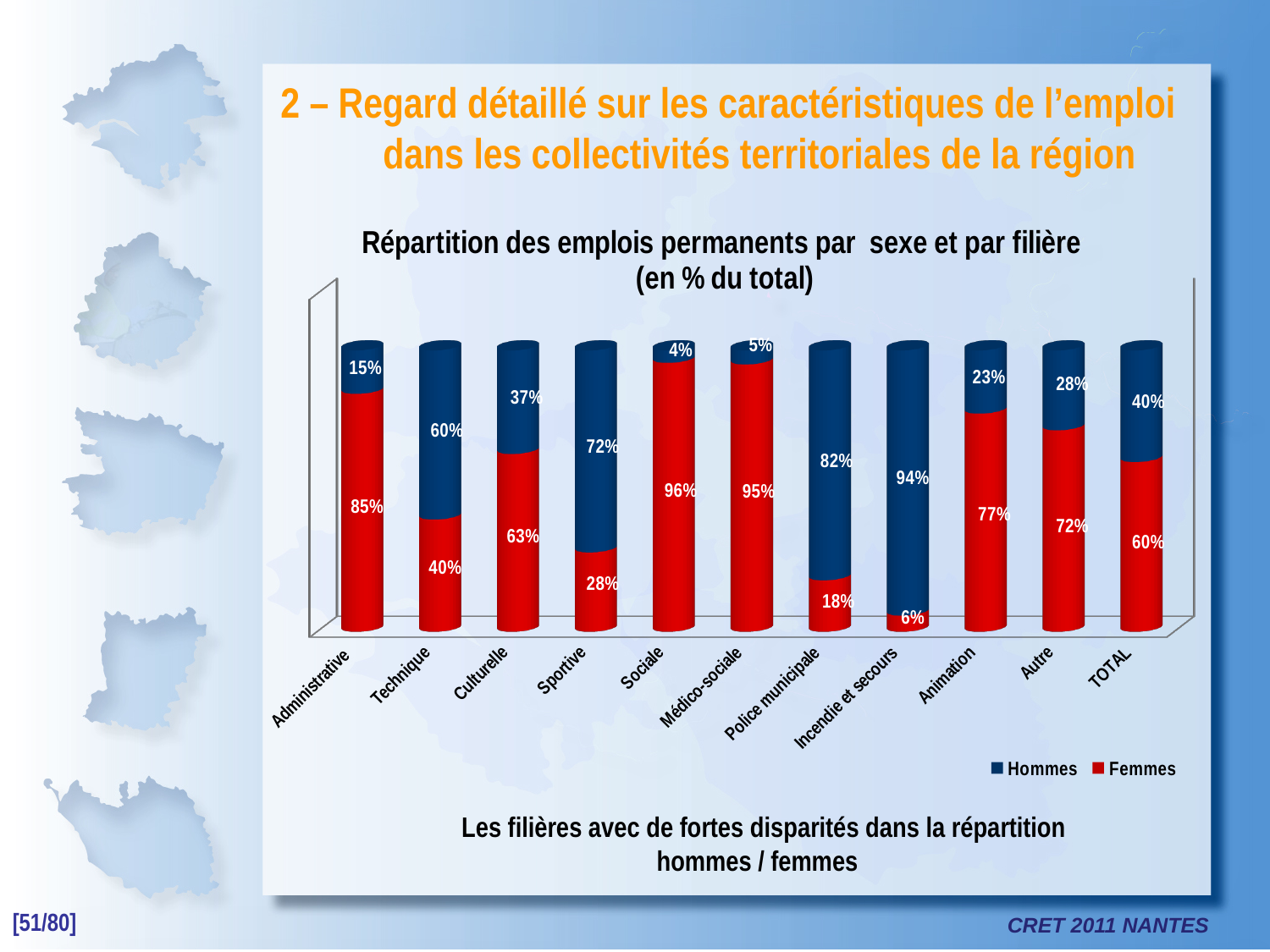
What is the Femmes value for Sportive? 28% Which category has the highest Femmes value? Sociale How many series does the legend list? 2 How many categories are shown on the x axis? 11 What is the difference between the Hommes and Femmes values for Technique? 20% Which category has the lowest Hommes value? Sociale What is the Femmes value for Administrative? 85% What kind of chart is this? Stacked bar chart Which series is shown in red? Femmes Which is larger, the Hommes value for Culturelle or the Hommes value for Animation? Culturelle What is the Hommes value for Incendie et secours? 94% What is the Hommes value for TOTAL? 40%